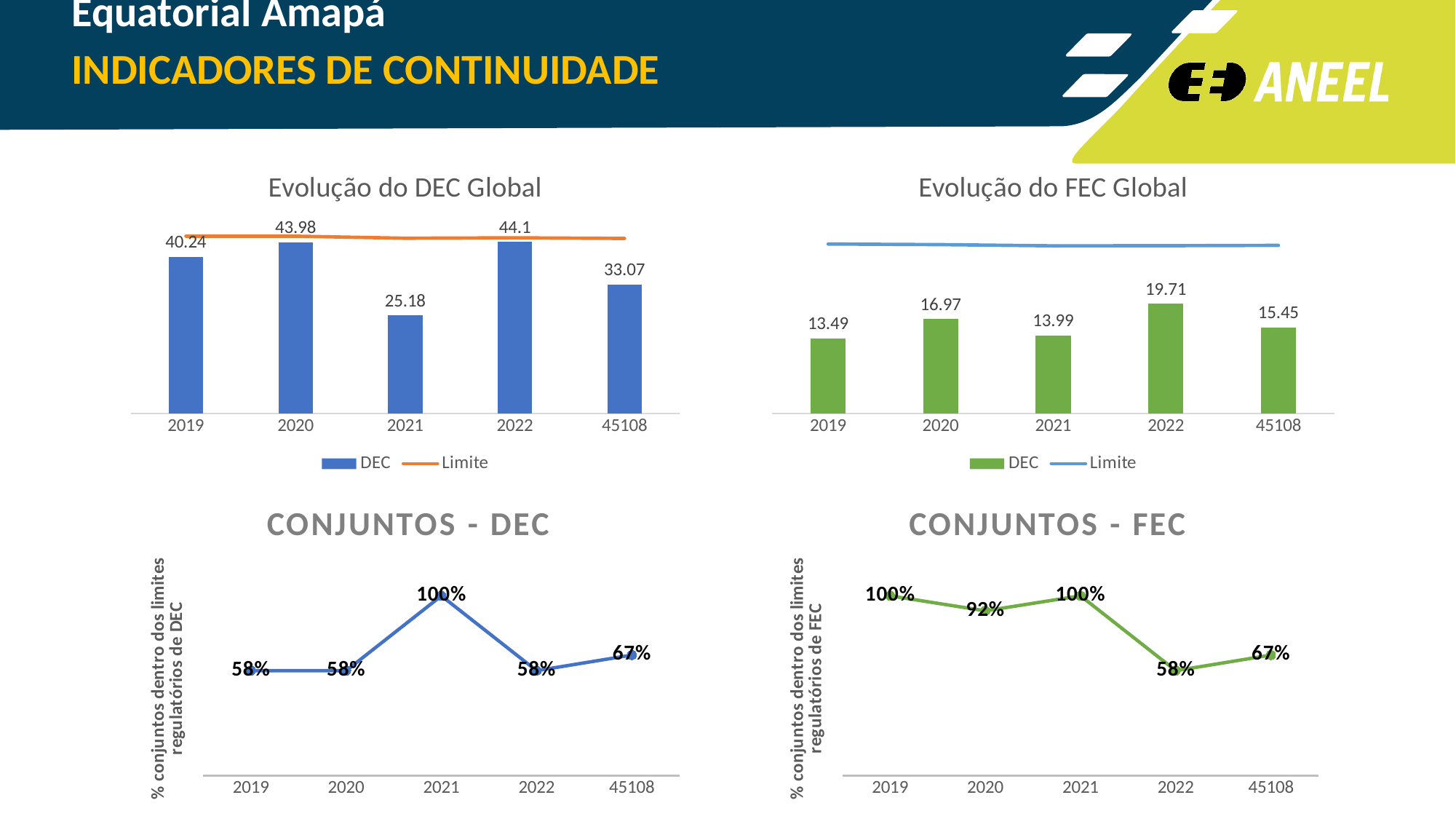
In the 'Evolução do FEC Global' chart, how many bars are plotted? 5 In the 'Evolução do DEC Global' chart, which year has the lowest DEC value? 2021 In the 'Evolução do DEC Global' chart, how many series does the legend list? 2 In the 'CONJUNTOS - DEC' chart, what is the value for 45108? 67% In the 'Evolução do FEC Global' chart, which year has the highest bar? 2022 In the 'CONJUNTOS - FEC' chart, what is the value for 2020? 92% What kind of chart is 'CONJUNTOS - FEC'? line chart In the 'Evolução do FEC Global' chart, which is larger: the value for 2020 or the value for 2021? 2020 In the 'Evolução do FEC Global' chart, what is the DEC value for 2022? 19.71 In the 'CONJUNTOS - DEC' chart, what is the value for 2021? 100% In the 'Evolução do DEC Global' chart, what is the DEC value for 2021? 25.18 In the 'Evolução do DEC Global' chart, what is the difference between the DEC values for 2020 and 2021? 18.8